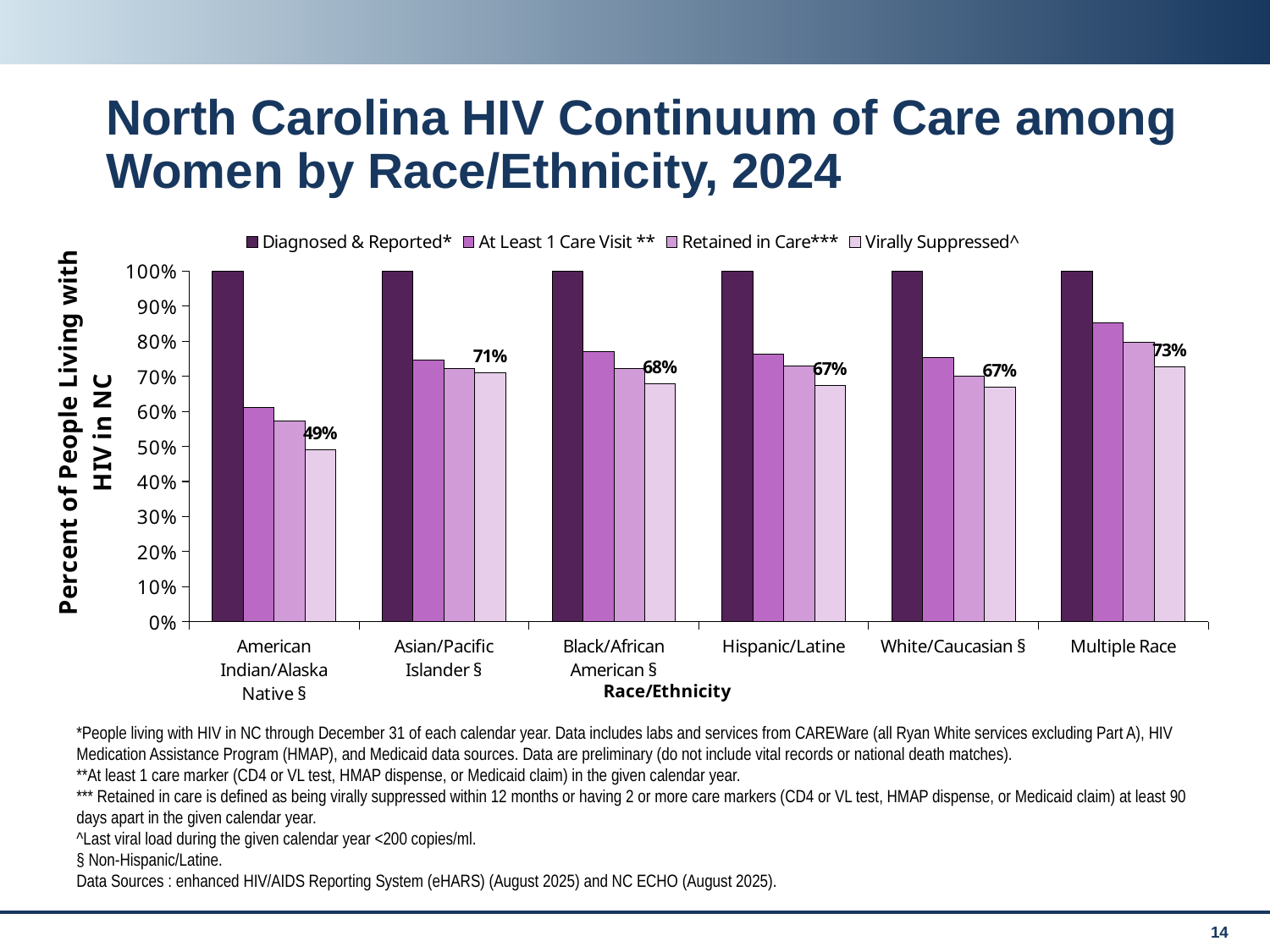
Which race/ethnicity group has the highest Virally Suppressed percentage? Multiple Race Which race/ethnicity group has the lowest Virally Suppressed percentage? American Indian/Alaska Native Is the At Least 1 Care Visit value for Multiple Race women greater or less than 80%? greater Which has a higher Virally Suppressed value: Asian/Pacific Islander or Black/African American? Asian/Pacific Islander Is the At Least 1 Care Visit value for American Indian/Alaska Native women greater or less than 70%? less How many race/ethnicity categories are shown on the x axis? 6 What is the Virally Suppressed value for Black/African American women? 68% What is the Virally Suppressed value for American Indian/Alaska Native women? 49% What is the difference in percentage points between the Virally Suppressed values for Multiple Race and American Indian/Alaska Native women? 24 percentage points What is the Virally Suppressed value for Multiple Race women? 73% How many series does the legend list? 4 What kind of chart is shown on the slide? Bar chart